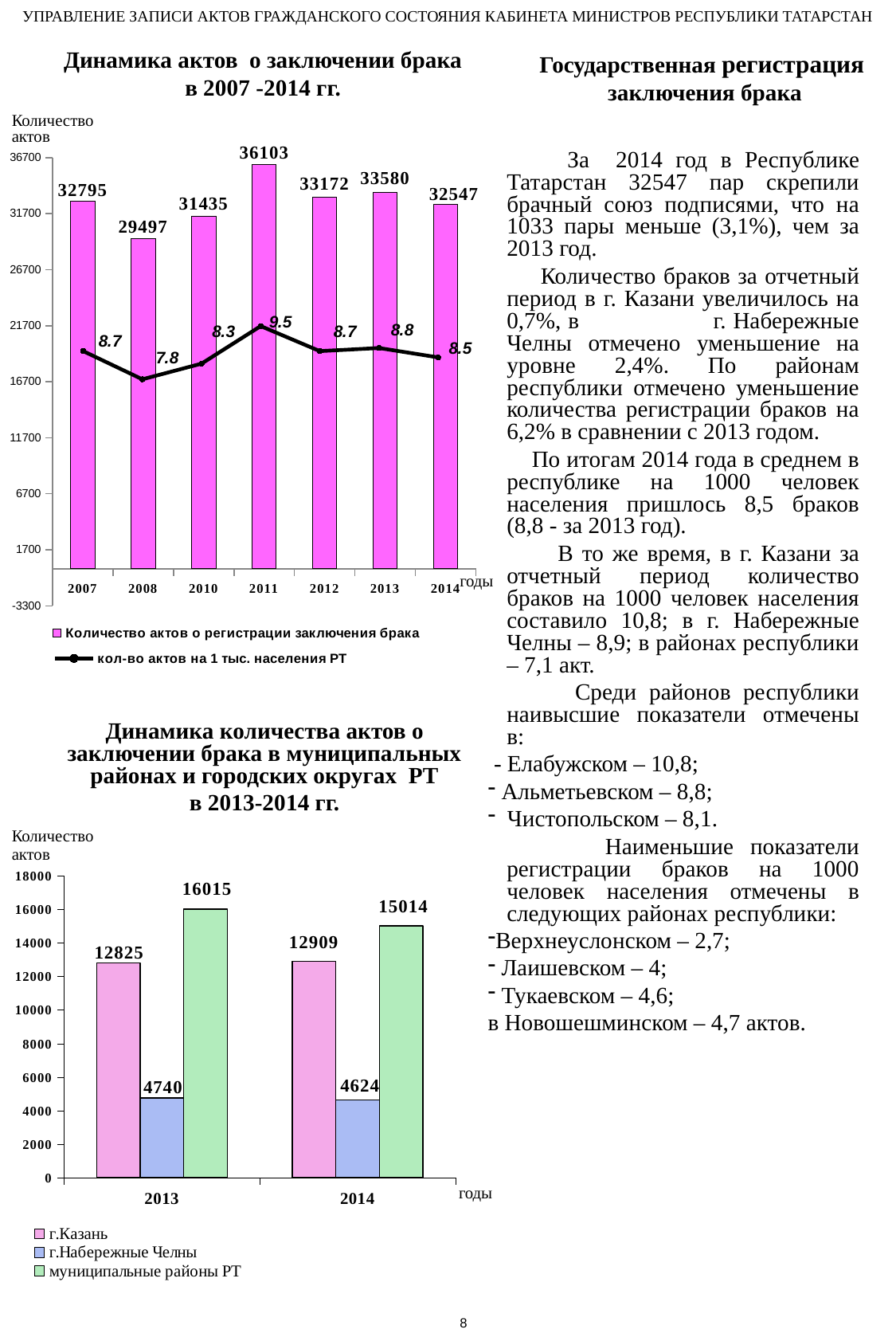
In the bottom chart 'Динамика количества актов о заключении брака в муниципальных районах и городских округах РТ', which series has the highest value in 2013? муниципальные районы РТ In the top chart 'Динамика актов о заключении брака в 2007-2014 гг.', what is the difference between the number of acts in 2013 and 2014? 1033 In the bottom chart 'Динамика количества актов о заключении брака в муниципальных районах и городских округах РТ', what is the value for 'г.Набережные Челны' in 2014? 4624 In the top chart 'Динамика актов о заключении брака в 2007-2014 гг.', how many years are shown on the x axis? 7 In the bottom chart 'Динамика количества актов о заключении брака в муниципальных районах и городских округах РТ', what is the difference between 'муниципальные районы РТ' in 2013 and 2014? 1001 In the top chart 'Динамика актов о заключении брака в 2007-2014 гг.', what is the number of marriage registration acts in 2011? 36103 In the top chart 'Динамика актов о заключении брака в 2007-2014 гг.', which year has the lowest number of marriage registration acts? 2008 In the bottom chart 'Динамика количества актов о заключении брака в муниципальных районах и городских округах РТ', is the value for 'г.Казань' in 2014 larger or smaller than in 2013? larger In the top chart 'Динамика актов о заключении брака в 2007-2014 гг.', which year has the highest number of marriage registration acts? 2011 In the top chart 'Динамика актов о заключении брака в 2007-2014 гг.', what is the value of 'кол-во актов на 1 тыс. населения РТ' for 2014? 8.5 In the top chart 'Динамика актов о заключении брака в 2007-2014 гг.', how many series does the legend list? 2 What kind of chart is the bottom chart 'Динамика количества актов о заключении брака в муниципальных районах и городских округах РТ'? bar chart